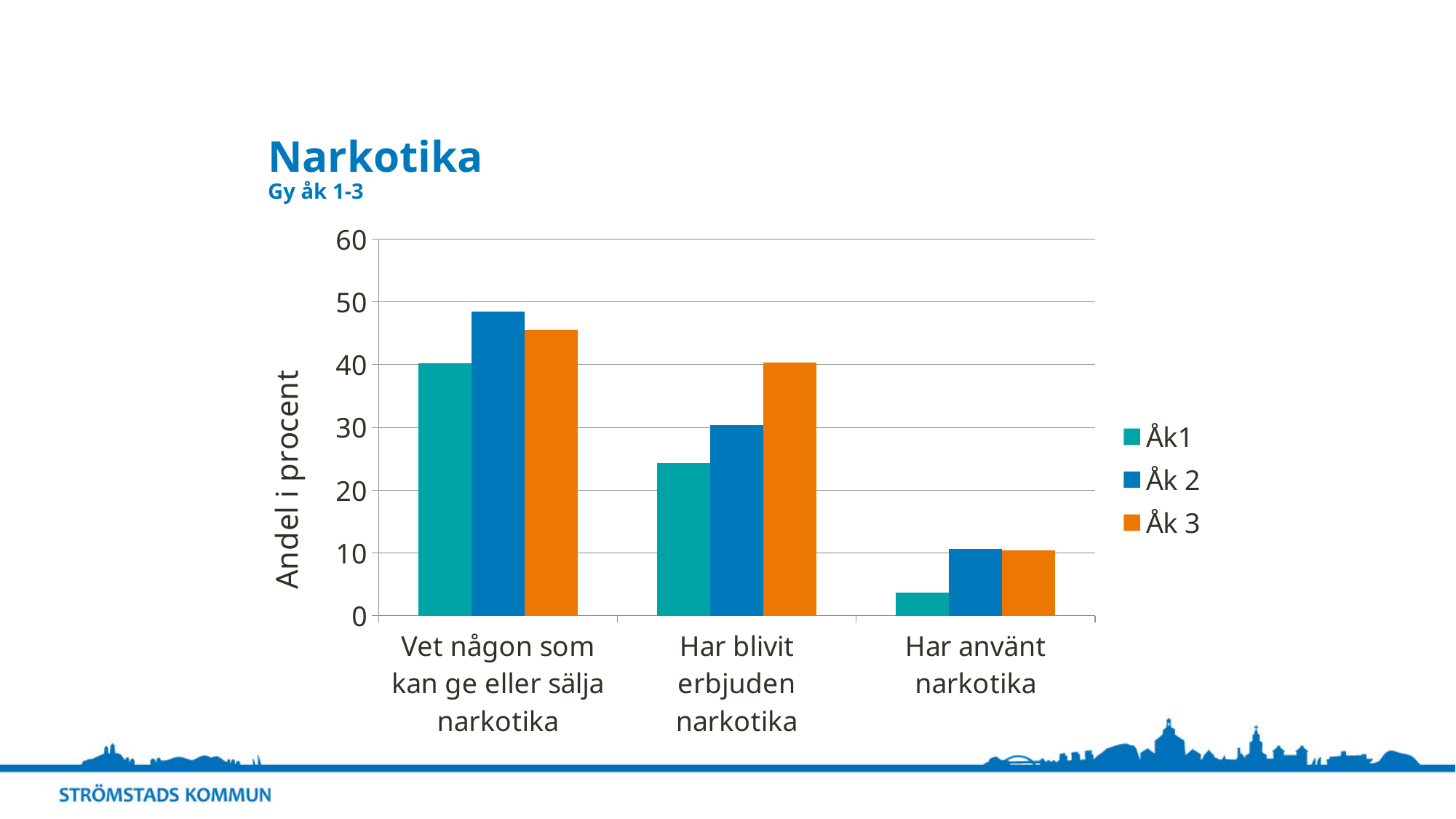
Which series has the lowest value for 'Har använt narkotika'? Åk1 What is the label of the y axis? Andel i procent How many categories are shown on the x axis? 3 Is the Åk1 value for 'Har blivit erbjuden narkotika' greater or less than 30? less What kind of chart is shown on the slide? bar chart How many series does the legend list? 3 Which series has the highest value for 'Vet någon som kan ge eller sälja narkotika'? Åk 2 Is the Åk 3 value for 'Vet någon som kan ge eller sälja narkotika' greater or less than 50? less Which series has the highest value for 'Har blivit erbjuden narkotika'? Åk 3 Is the Åk 2 value for 'Vet någon som kan ge eller sälja narkotika' greater or less than 40? greater For Åk1, which is larger: the value for 'Vet någon som kan ge eller sälja narkotika' or the value for 'Har blivit erbjuden narkotika'? Vet någon som kan ge eller sälja narkotika